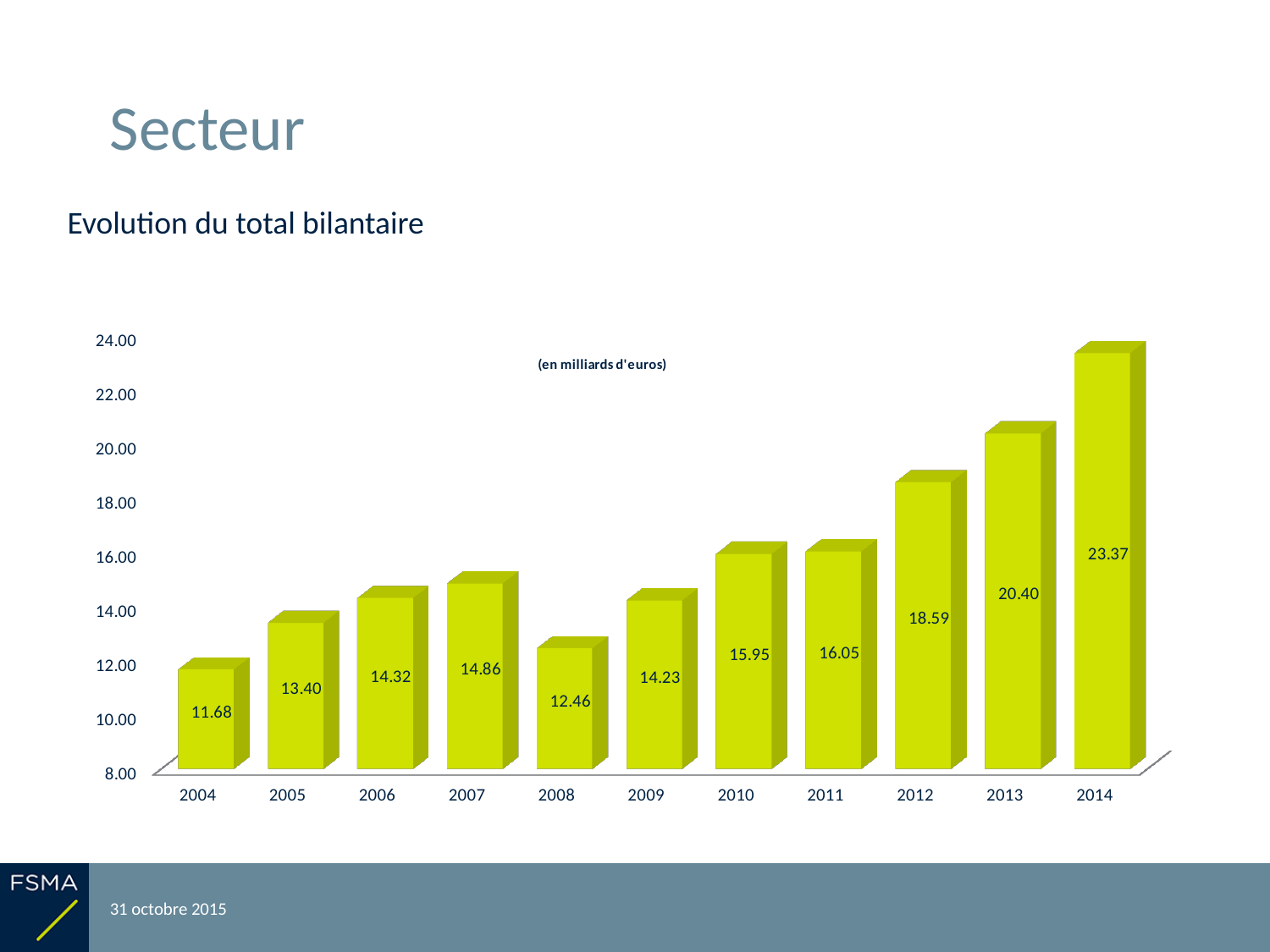
What is the value for 2004? 11.68 What is the value for 2012? 18.59 Which is larger, the value for 2009 or the value for 2007? 2007 What kind of chart is shown on the slide? bar chart What unit is indicated in the chart's label? en milliards d'euros What is the difference between the values for 2014 and 2013? 2.97 What is the difference between the values for 2007 and 2008? 2.40 Which year has the highest value? 2014 Which year has the lowest value? 2004 Is the value for 2013 greater or less than 20.00? greater What is the value for 2008? 12.46 How many years are shown on the x axis? 11